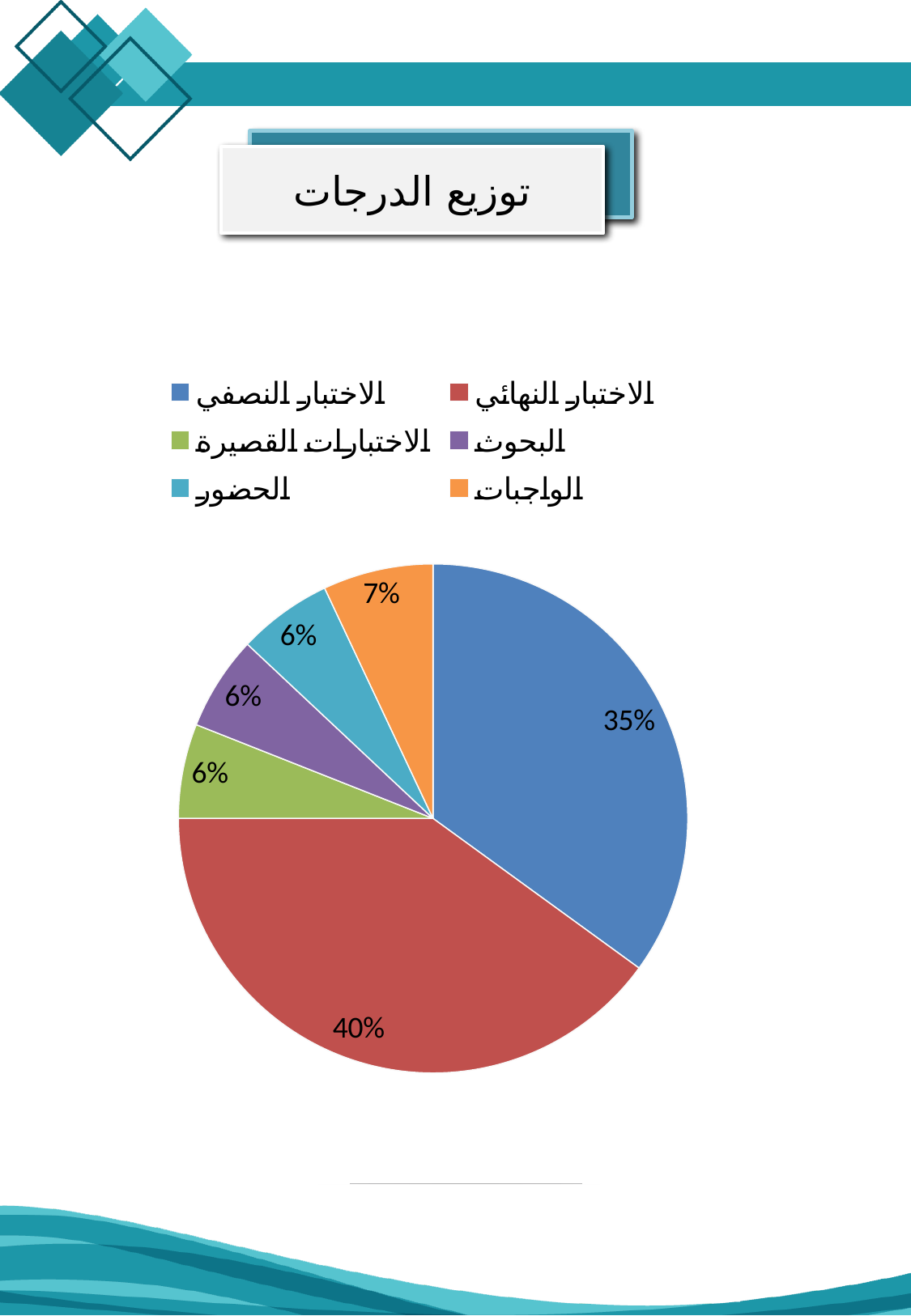
What percentage does the slice for الحضور represent? 6% What percentage does the slice for الاختبار النهائي represent? 40% Which is larger, the slice for الواجبات or the slice for البحوث? الواجبات What percentage does the slice for الاختبار النصفي represent? 35% What percentage does the slice for الواجبات represent? 7% What kind of chart is shown on the slide? pie chart What is the combined percentage of الاختبار النهائي and الاختبار النصفي? 75% What is the title shown above the chart? توزيع الدرجات What colour is the slice for الاختبار النصفي? blue How many categories does the legend list? 6 What is the difference between the percentages for الاختبار النهائي and الاختبار النصفي? 5% Which category has the largest slice of the pie? الاختبار النهائي